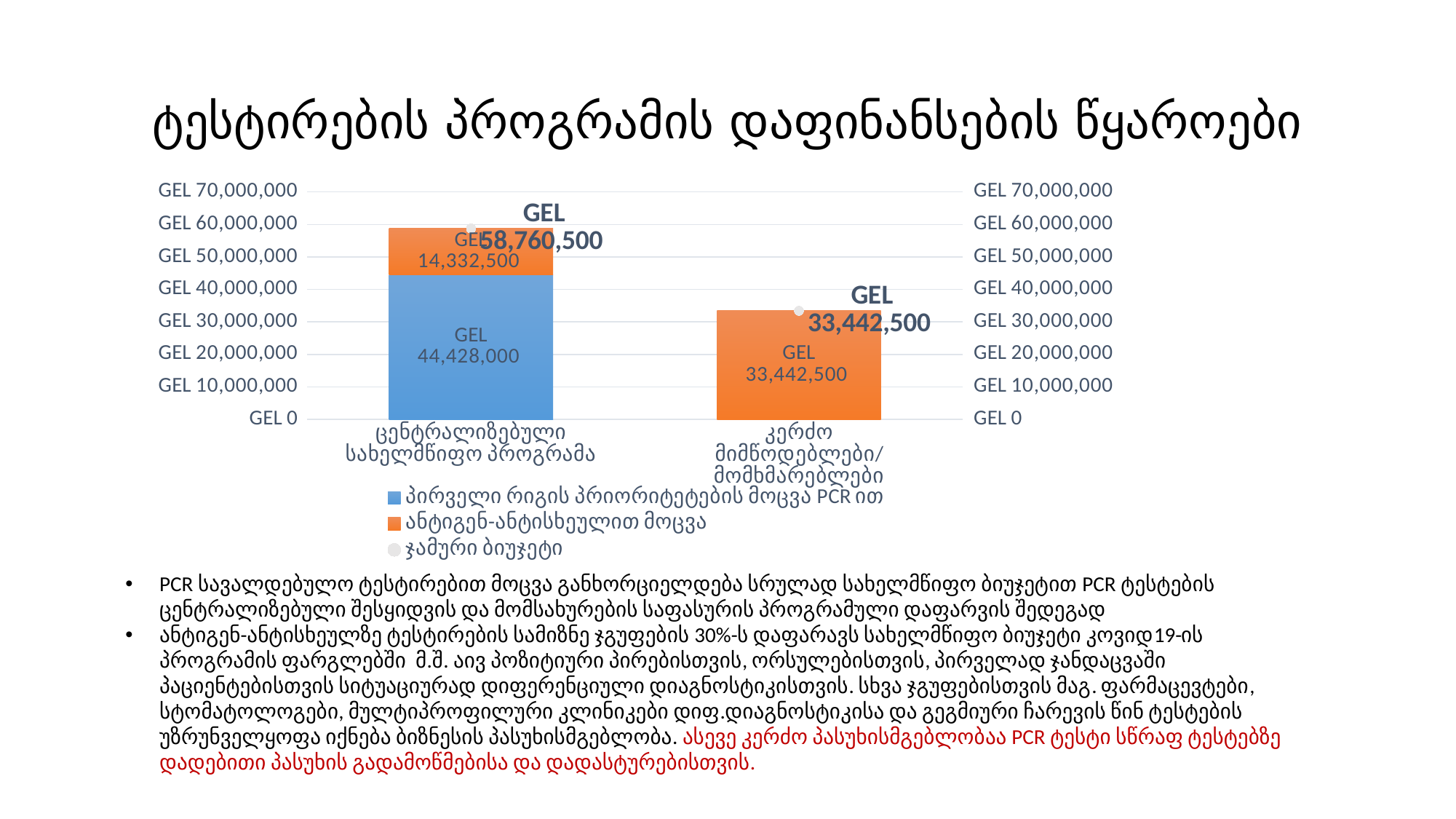
What kind of chart is shown on the slide? Stacked bar chart What is the ჯამური ბიუჯეტი (total budget) shown for ცენტრალიზებული სახელმწიფო პროგრამა? GEL 58,760,500 What is the difference between the total budgets of ცენტრალიზებული სახელმწიფო პროგრამა and კერძო მიმწოდებლები/მომხმარებლები? GEL 25,318,000 How many categories are shown on the x axis? 2 How many series does the legend list? 3 What is the value of the orange series (ანტიგენ-ანტისხეულით მოცვა) for ცენტრალიზებული სახელმწიფო პროგრამა? GEL 14,332,500 What is the value of the blue series (პირველი რიგის პრიორიტეტების მოცვა PCR ით) for ცენტრალიზებული სახელმწიფო პროგრამა? GEL 44,428,000 What is the value of the orange series (ანტიგენ-ანტისხეულით მოცვა) for კერძო მიმწოდებლები/მომხმარებლები? GEL 33,442,500 Which category has the higher total budget? ცენტრალიზებული სახელმწიფო პროგრამა Which is larger: the orange segment for ცენტრალიზებული სახელმწიფო პროგრამა or the orange segment for კერძო მიმწოდებლები/მომხმარებლები? კერძო მიმწოდებლები/მომხმარებლები What is the ჯამური ბიუჯეტი (total budget) shown for კერძო მიმწოდებლები/მომხმარებლები? GEL 33,442,500 Is the total for ცენტრალიზებული სახელმწიფო პროგრამა greater or less than GEL 50,000,000? greater